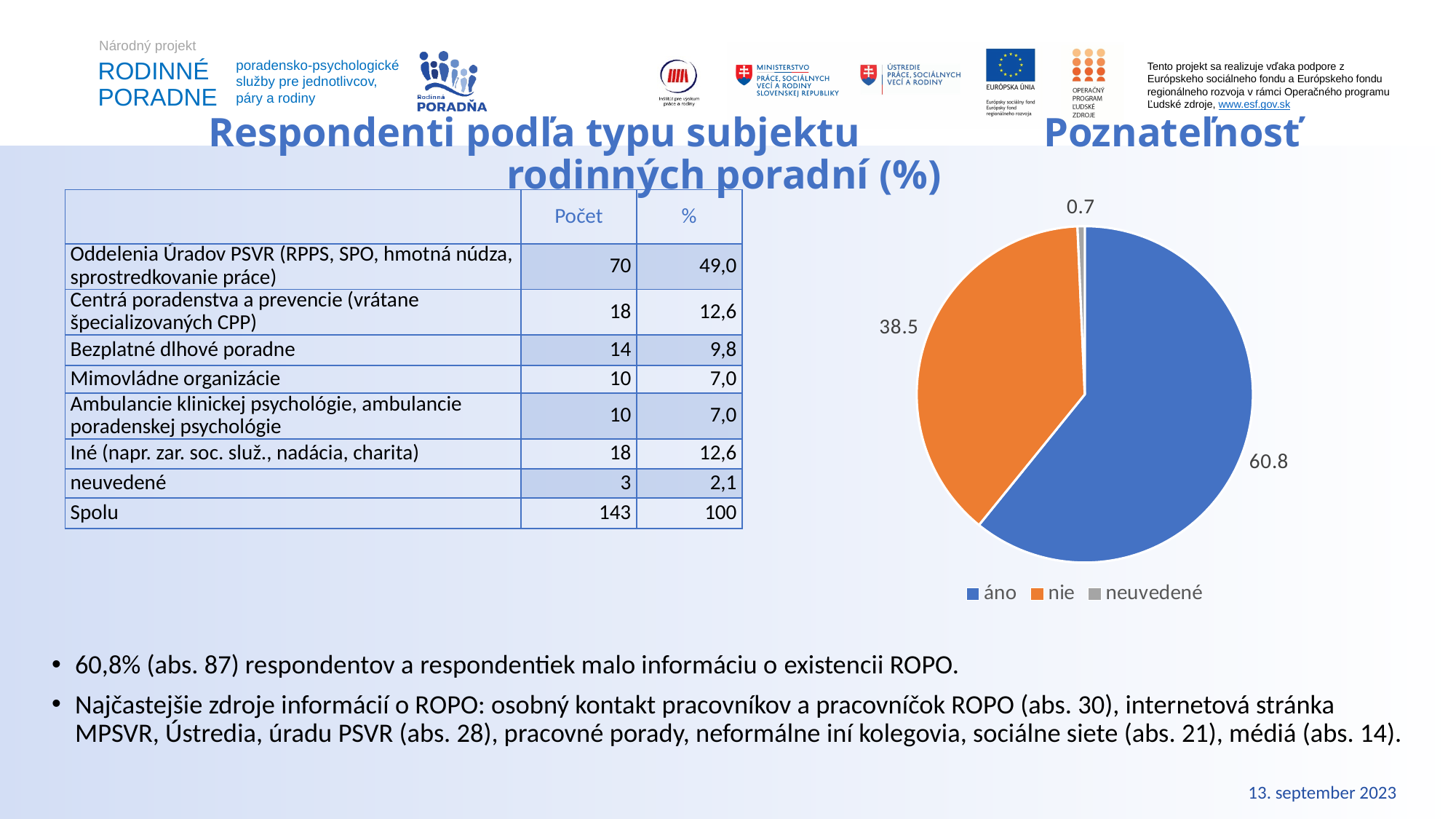
In the "Poznateľnosť" pie chart, what is the value for "neuvedené"? 0.7 In the "Poznateľnosť" pie chart, what is the value for "nie"? 38.5 How many entries does the legend of the "Poznateľnosť" pie chart list? 3 Which slice of the "Poznateľnosť" pie chart is the largest? áno In the "Poznateľnosť" pie chart, what colour is the "áno" slice? blue Which slice of the "Poznateľnosť" pie chart is the smallest? neuvedené In the "Poznateľnosť" pie chart, what is the difference between the values for "áno" and "nie"? 22.3 In the "Poznateľnosť" pie chart, what is the value for "áno"? 60.8 What kind of chart is shown under the title "Poznateľnosť"? pie chart In the "Poznateľnosť" pie chart, what colour is the "nie" slice? orange In the "Poznateľnosť" pie chart, which is larger, "nie" or "neuvedené"? nie How many slices does the "Poznateľnosť" pie chart have? 3